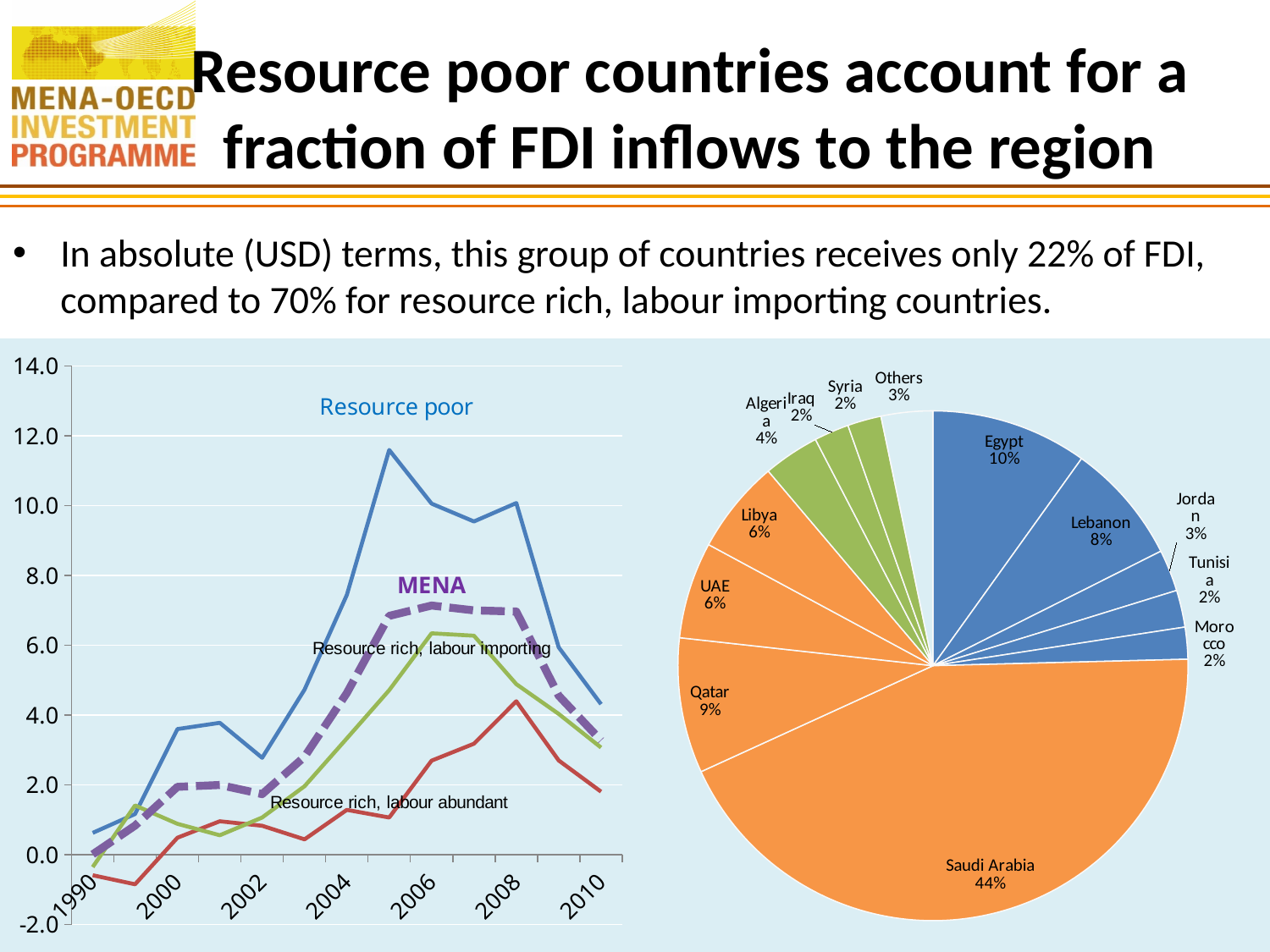
In the pie chart on the right, what share does Saudi Arabia account for? 44% In the line chart on the left, which line is highest at 2006? Resource poor In the line chart on the left, is the peak value of the Resource poor line greater or less than 10.0? greater In the pie chart on the right, which country has the largest slice? Saudi Arabia In the pie chart on the right, what is the difference in percentage points between Egypt's share and Lebanon's share? 2 percentage points In the line chart on the left, is the value of the Resource poor line at 2010 greater or less than 6.0? less In the pie chart on the right, what share does Qatar account for? 9% What kind of chart is the chart on the right of the slide? Pie chart What kind of chart is the chart on the left of the slide? Line chart In the pie chart on the right, how many slices are shown? 13 In the pie chart on the right, which has the larger share, Qatar or Lebanon? Qatar In the pie chart on the right, what share does Egypt account for? 10%